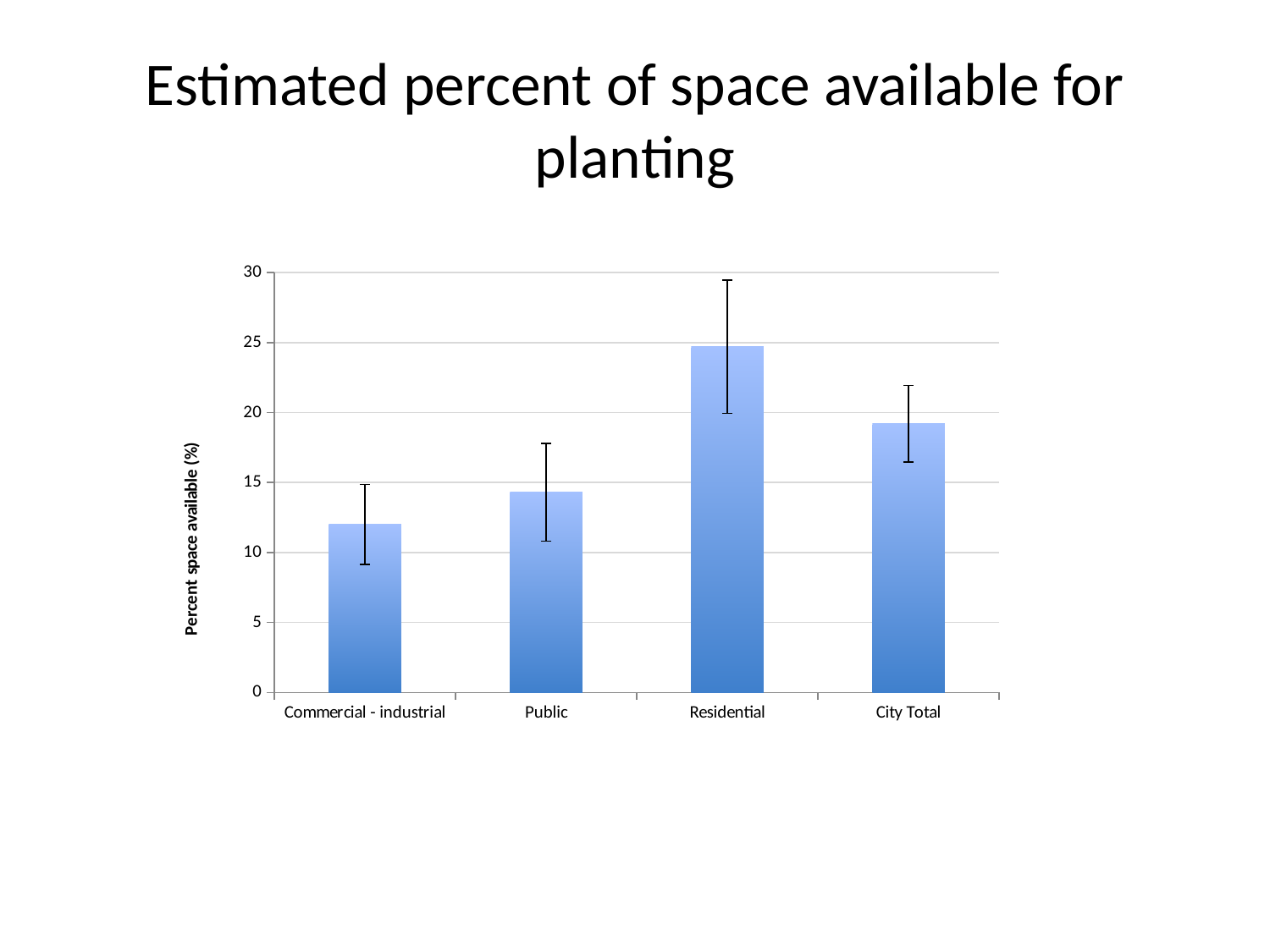
Is the value for City Total greater or less than 20? less What is the label on the vertical axis of the chart? Percent space available (%) Is the value for Commercial - industrial greater or less than 10? greater How many categories are plotted on the x axis of the chart? 4 Which is larger, the value for Public or the value for Commercial - industrial? Public Which is larger, the value for Residential or the value for City Total? Residential Is the value for City Total greater or less than 15? greater What kind of chart is shown on the slide? bar chart Which category has the highest estimated percent of space available for planting? Residential Which category has the lowest estimated percent of space available for planting? Commercial - industrial